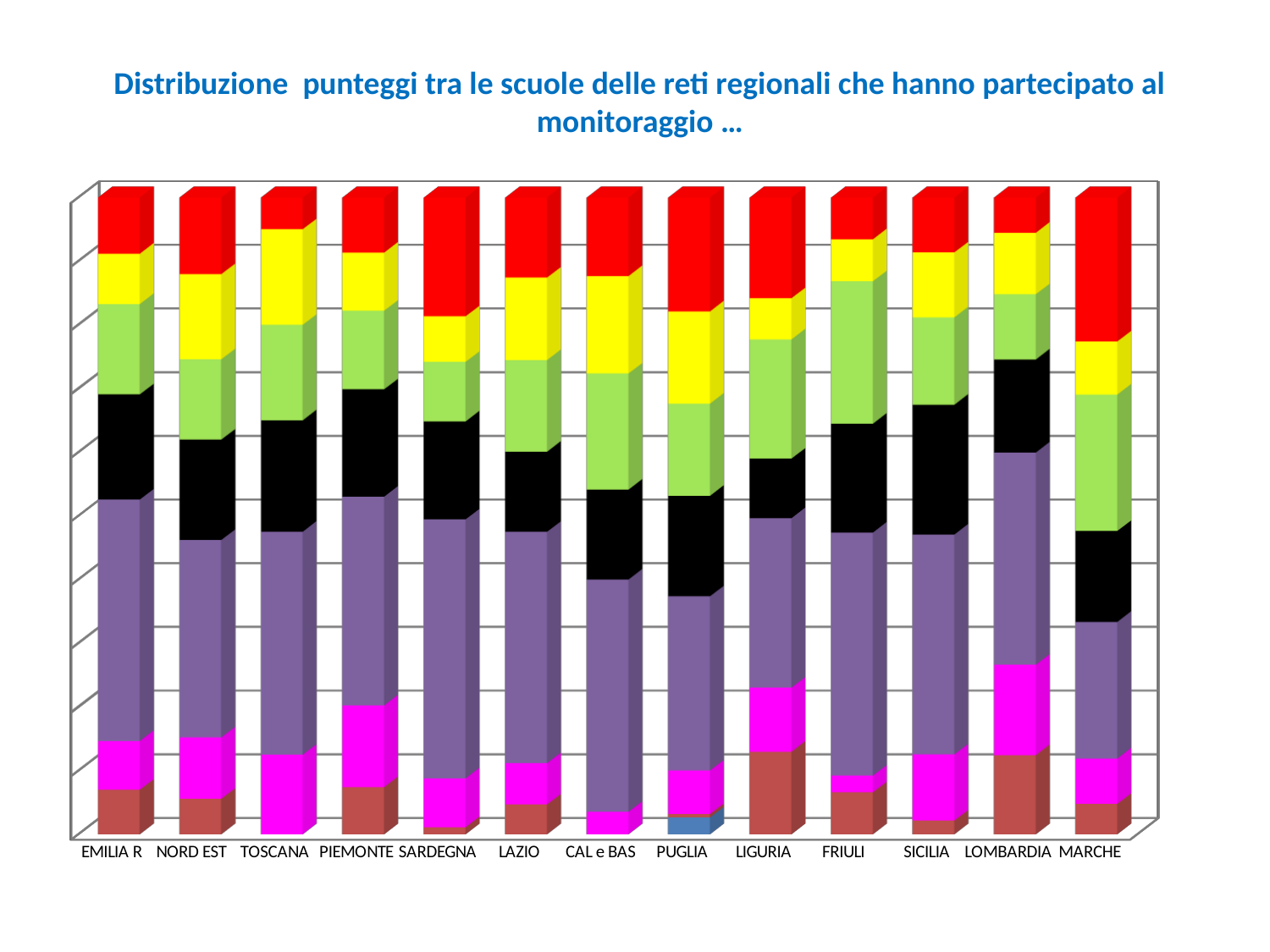
Which category appears first (leftmost) on the x axis? EMILIA R What kind of chart is shown on the slide? Stacked bar chart Is the green segment larger for MARCHE or for PUGLIA? MARCHE How many regional categories are shown along the x axis of the chart? 13 Is the purple segment larger for LOMBARDIA or for PUGLIA? LOMBARDIA Is the red segment larger for MARCHE or for EMILIA R? MARCHE Which category is the only one with a blue segment at the bottom of its bar? PUGLIA What is the title of the chart on the slide? Distribuzione punteggi tra le scuole delle reti regionali che hanno partecipato al monitoraggio … Which category has the largest red segment in its bar? MARCHE Which category appears last (rightmost) on the x axis? MARCHE Does the chart include a legend identifying the colored segments? No